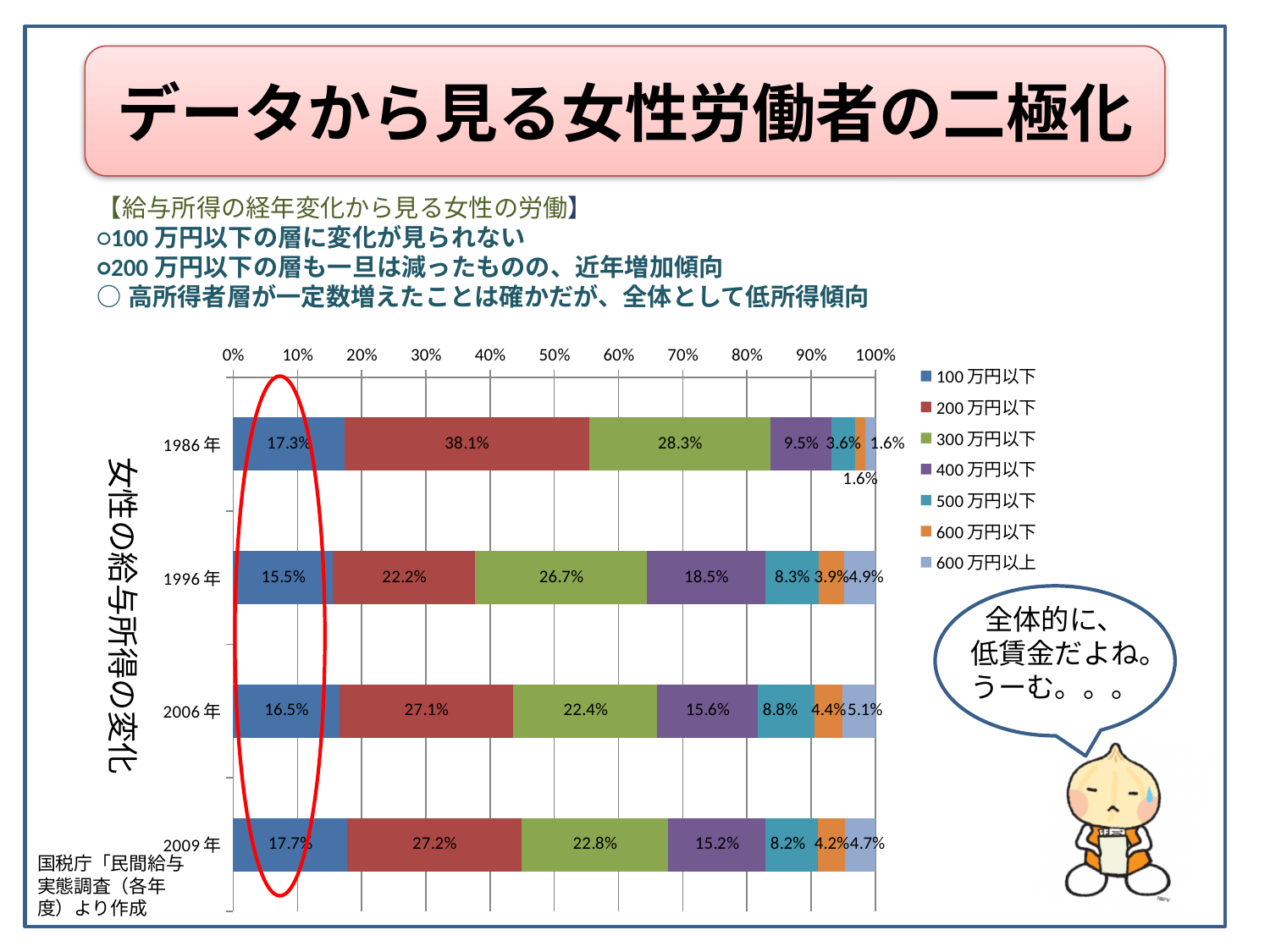
Which is larger: the 500万円以下 value in 2006年 or in 2009年? 2006年 What is the value for 400万円以下 in 1996年? 18.5% What is the value for 100万円以下 in 1986年? 17.3% What is the difference between the 300万円以下 values for 1986年 and 2009年? 5.5% Does the value for 400万円以下 rise or fall from 1986年 to 1996年? Rise What is the title shown along the vertical axis of the chart? 女性の給与所得の変化 Which year has the lowest value for 100万円以下? 1996年 Which year has the highest value for 200万円以下? 1986年 What kind of chart is shown on the slide? Stacked bar chart How many series does the legend list? 7 What is the value for 200万円以下 in 2009年? 27.2% How many years (categories) are plotted on the chart? 4